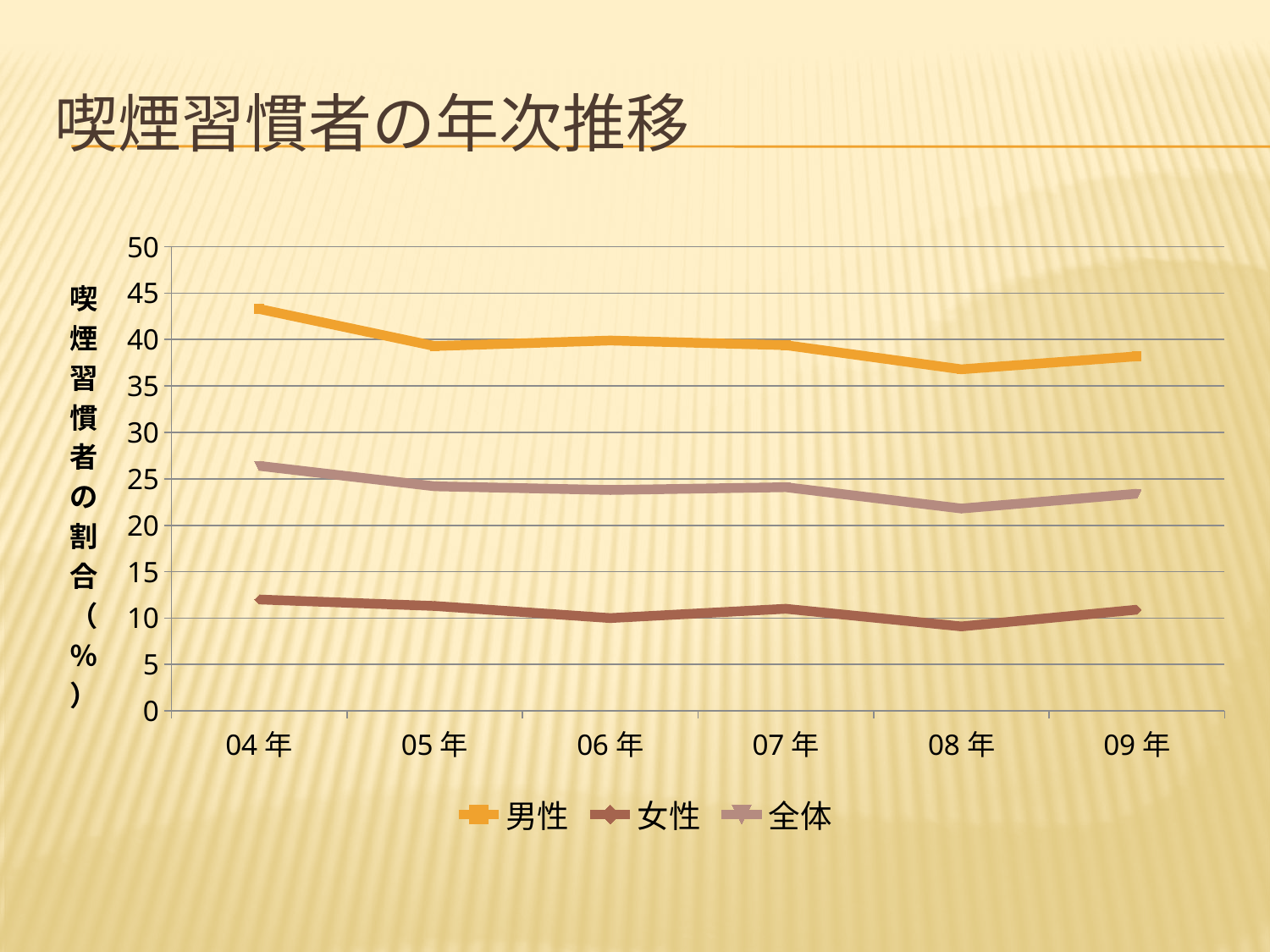
What kind of chart is shown on the slide? line chart Which series has the highest values across all years? 男性 Is the value for 女性 in 04年 greater or less than 10? greater How many years are shown along the x axis? 6 How many series does the legend list? 3 Which series has the lowest values across all years? 女性 Is the value for 男性 in 04年 greater or less than 40? greater In which year is the 男性 value highest? 04年 What is the title of the chart? 喫煙習慣者の年次推移 Is the value for 全体 in 08年 greater or less than 25? less Which is larger, the 全体 value in 04年 or the 全体 value in 08年? 04年 In which year is the 男性 value lowest? 08年